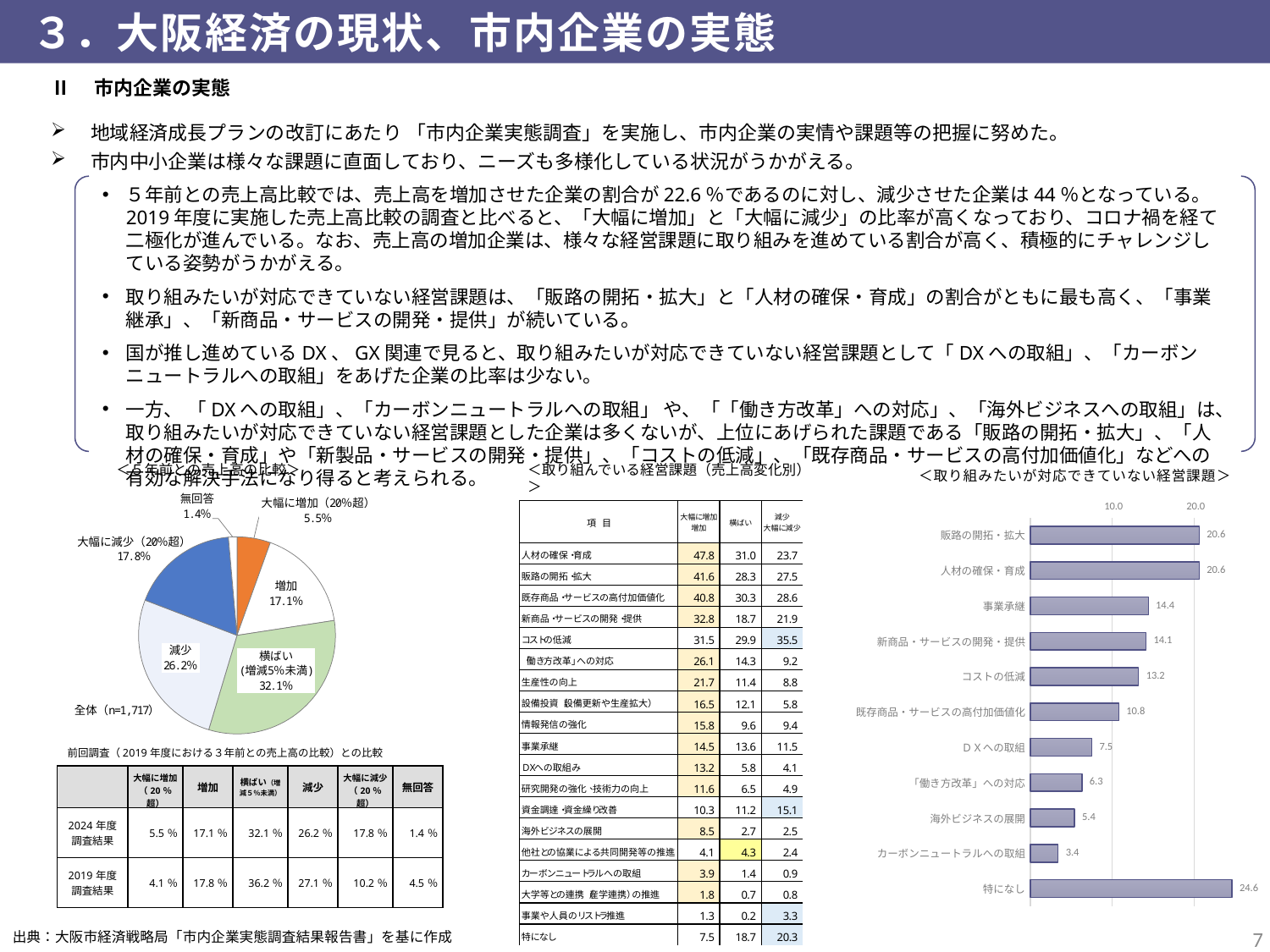
In the bar chart on the right, which category has the longest bar? 特になし In the pie chart on the left, how many slices are there? 6 In the pie chart on the left, what is the difference between the shares of 減少 and 増加? 9.1% In the pie chart on the left, which category has the largest share? 横ばい (増減5%未満) In the pie chart on the left, which category has the smallest share? 無回答 What type of chart is the chart on the left of the slide? Pie chart In the pie chart on the left (5年前との売上高の比較), what share is 横ばい (増減5%未満)? 32.1% What type of chart is the chart on the right of the slide? Bar chart In the bar chart on the right, what is the value for カーボンニュートラルへの取組? 3.4 In the bar chart on the right (取り組みたいが対応できていない経営課題), what is the value for 事業承継? 14.4 In the bar chart on the right, which is larger: コストの低減 or DXへの取組? コストの低減 In the pie chart on the left, what share is 大幅に減少 (20%超)? 17.8%